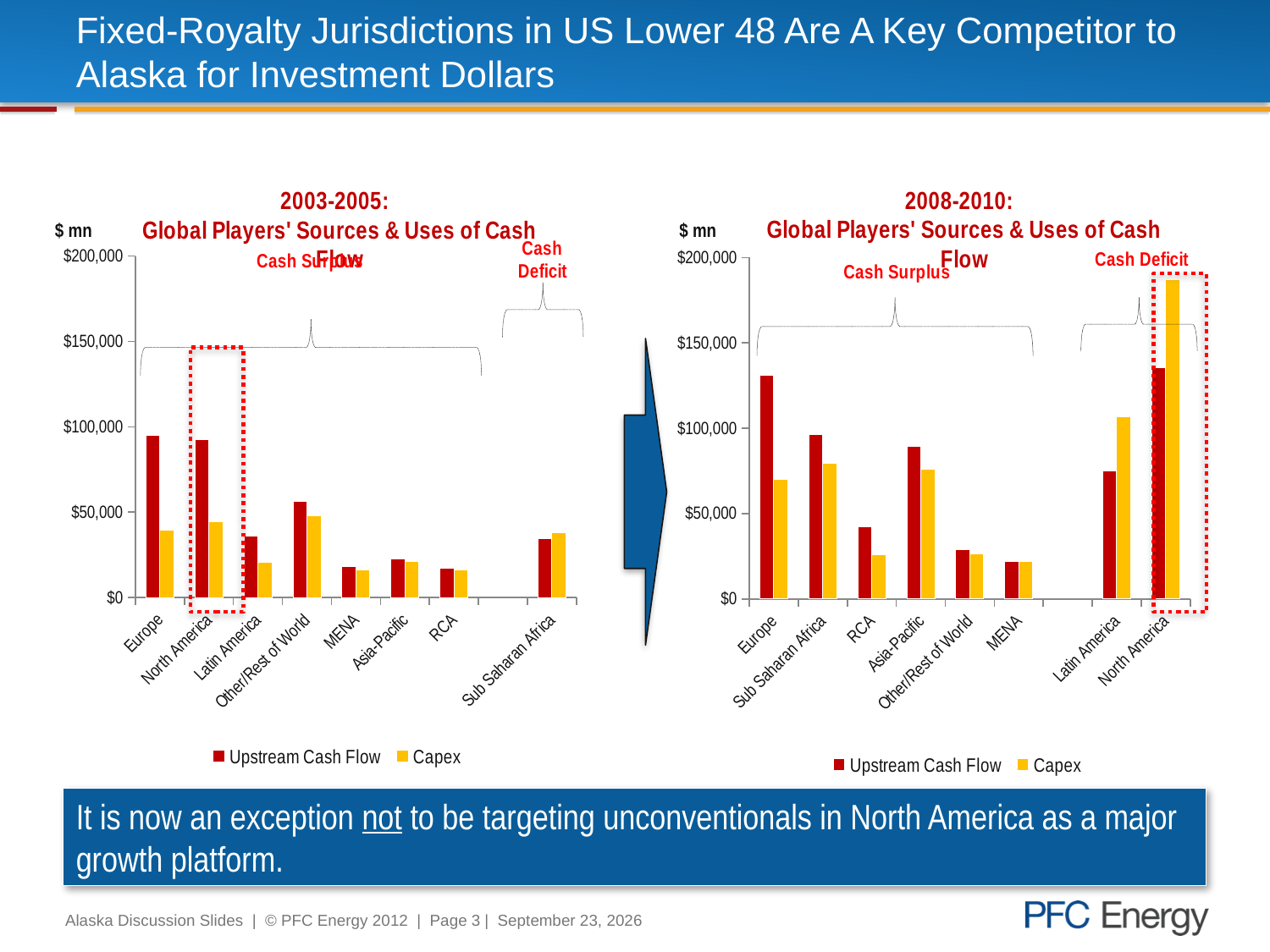
What kind of chart is the 2003-2005 Global Players' Sources & Uses of Cash Flow chart? Bar chart In the 2003-2005 chart, is the Upstream Cash Flow for Europe greater or less than $50,000? greater How many series does the legend of the 2008-2010 chart list? 2 In the 2008-2010 chart, which is larger for Latin America: Upstream Cash Flow or Capex? Capex In the 2003-2005 chart, is the Upstream Cash Flow for Latin America greater or less than $50,000? less In the 2008-2010 chart, is the Capex for North America greater or less than $150,000? greater In the 2003-2005 chart, which is larger for Europe: Upstream Cash Flow or Capex? Upstream Cash Flow In the 2008-2010 chart, which region has the highest Capex? North America In the 2008-2010 chart, which region has the lowest Upstream Cash Flow? MENA How many regions are shown on the x axis of the 2003-2005 chart? 8 What are the two legend entries of the 2003-2005 chart? Upstream Cash Flow and Capex